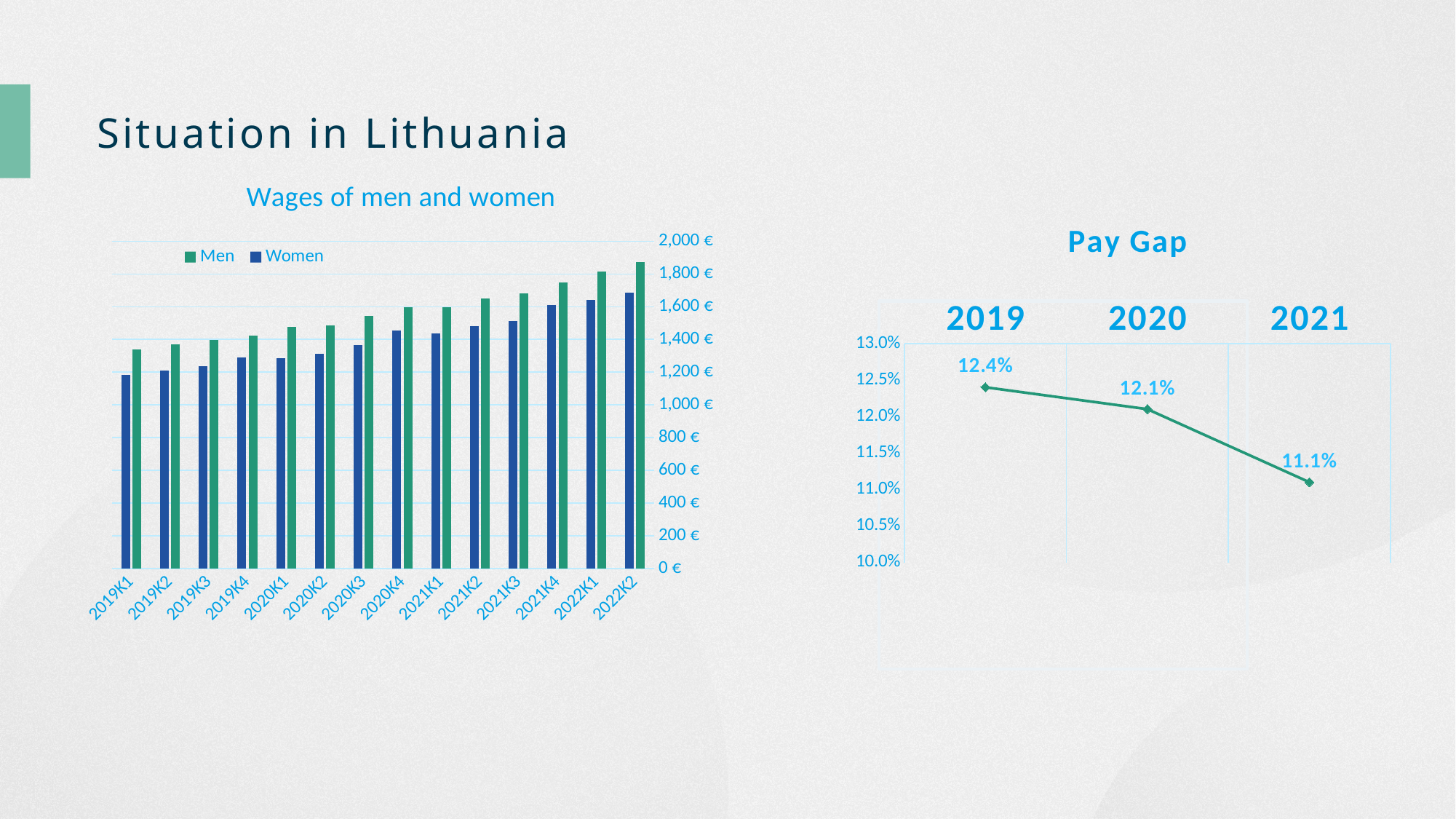
How many quarters are shown on the x axis of the Wages of men and women chart? 14 In the Pay Gap chart, does the pay gap rise or fall from 2019 to 2021? fall In the Pay Gap chart, what was the pay gap in 2019? 12.4% In the Pay Gap chart, by how many percentage points did the pay gap fall from 2019 to 2021? 1.3 percentage points What kind of chart is the Pay Gap chart? line chart How many series does the legend of the Wages of men and women chart list? 2 How many data points are plotted in the Pay Gap chart? 3 What kind of chart is the Wages of men and women chart? bar chart In the Wages of men and women chart, do wages generally rise or fall from 2019K1 to 2022K2? rise In the Pay Gap chart, what was the pay gap in 2021? 11.1% In the Wages of men and women chart, is the value for Men in 2022K2 greater or less than 1,800 €? greater In the Pay Gap chart, which year has the lowest pay gap? 2021